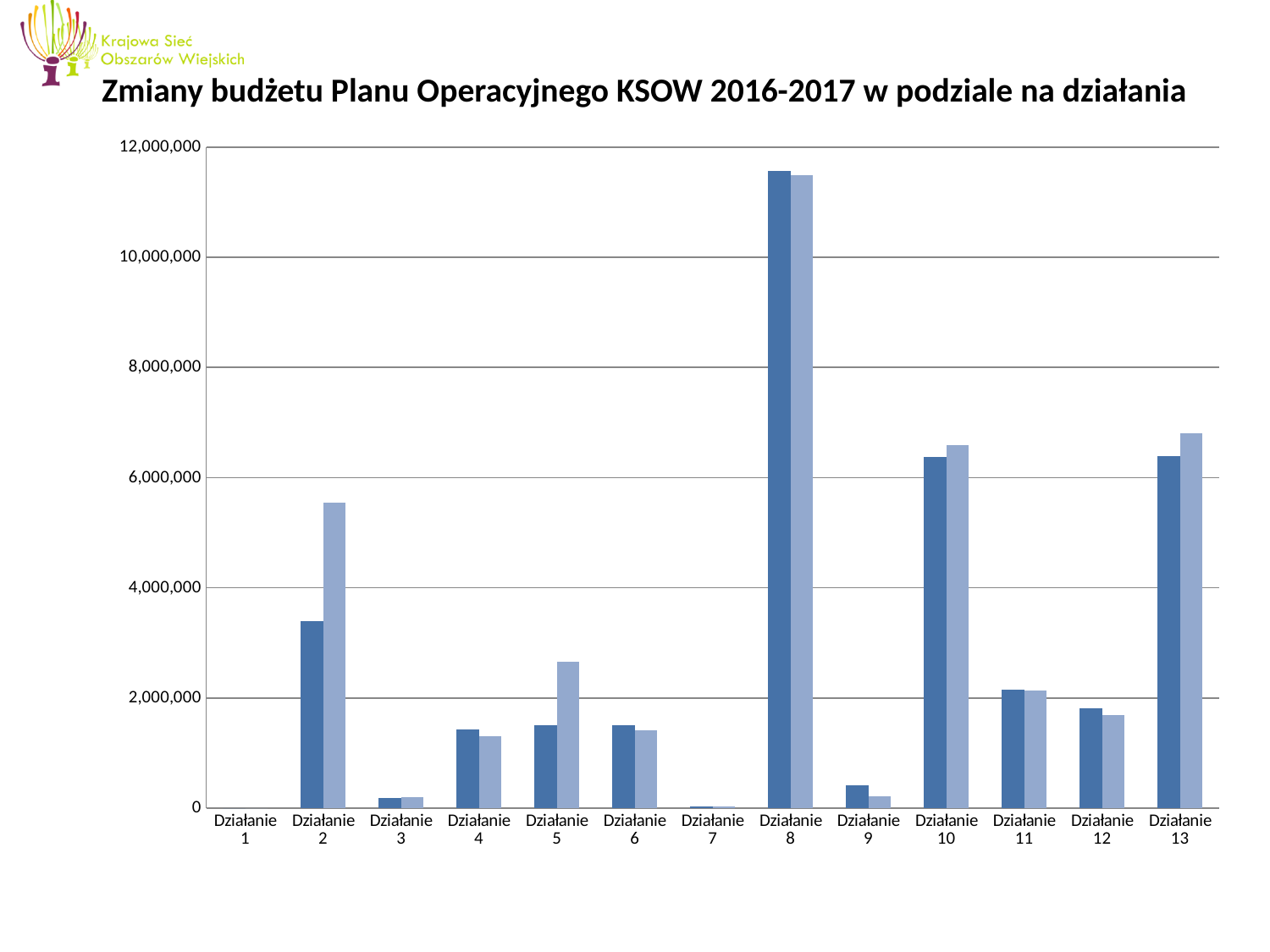
Is the value of the dark blue bar for Działanie 2 greater or less than 4,000,000? less How many categories (Działanie) are shown on the x axis? 13 Is the value of the light blue bar for Działanie 2 greater or less than 4,000,000? greater For Działanie 5, which bar is taller, the dark blue or the light blue one? light blue Is the value of the dark blue bar for Działanie 4 greater or less than 2,000,000? less What is the title of the chart? Zmiany budżetu Planu Operacyjnego KSOW 2016-2017 w podziale na działania Which category has the highest bars in the chart? Działanie 8 For Działanie 9, which bar is taller, the dark blue or the light blue one? dark blue Which has the larger dark blue bar, Działanie 2 or Działanie 10? Działanie 10 What kind of chart is shown on the slide? bar chart